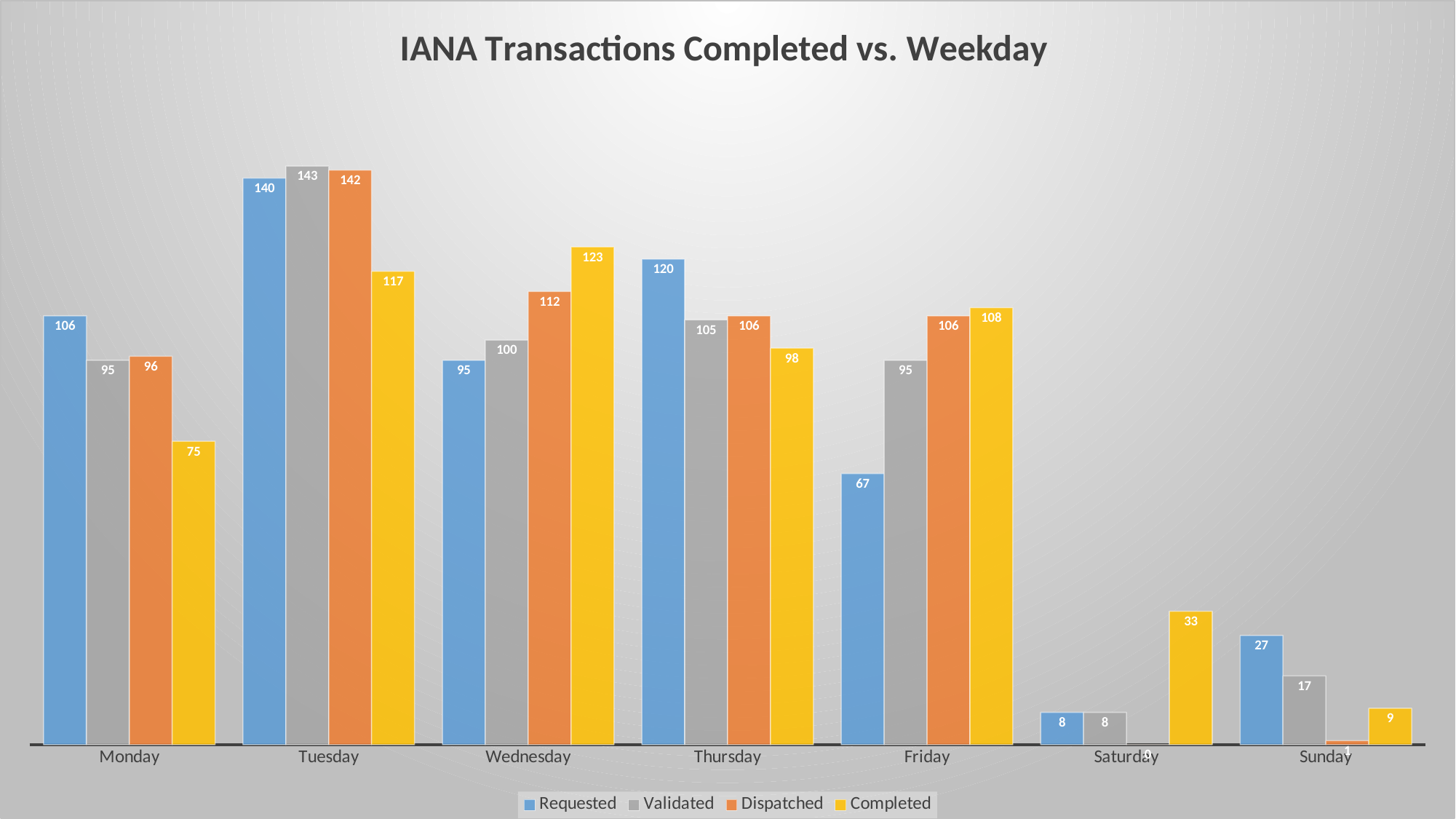
How many series does the legend list? 4 What kind of chart is shown on the slide? Bar chart How many weekday categories are shown on the x axis? 7 Which is larger for Thursday, the Requested value or the Completed value? Requested Which weekday has the lowest Completed value? Sunday Which colour represents the Completed series in the legend? Yellow What is the Dispatched value for Friday? 106 What is the Completed value for Wednesday? 123 Which weekday has the highest Validated value? Tuesday What is the title of the chart? IANA Transactions Completed vs. Weekday What is the difference between the Requested and Completed values for Monday? 31 What is the Requested value for Tuesday? 140